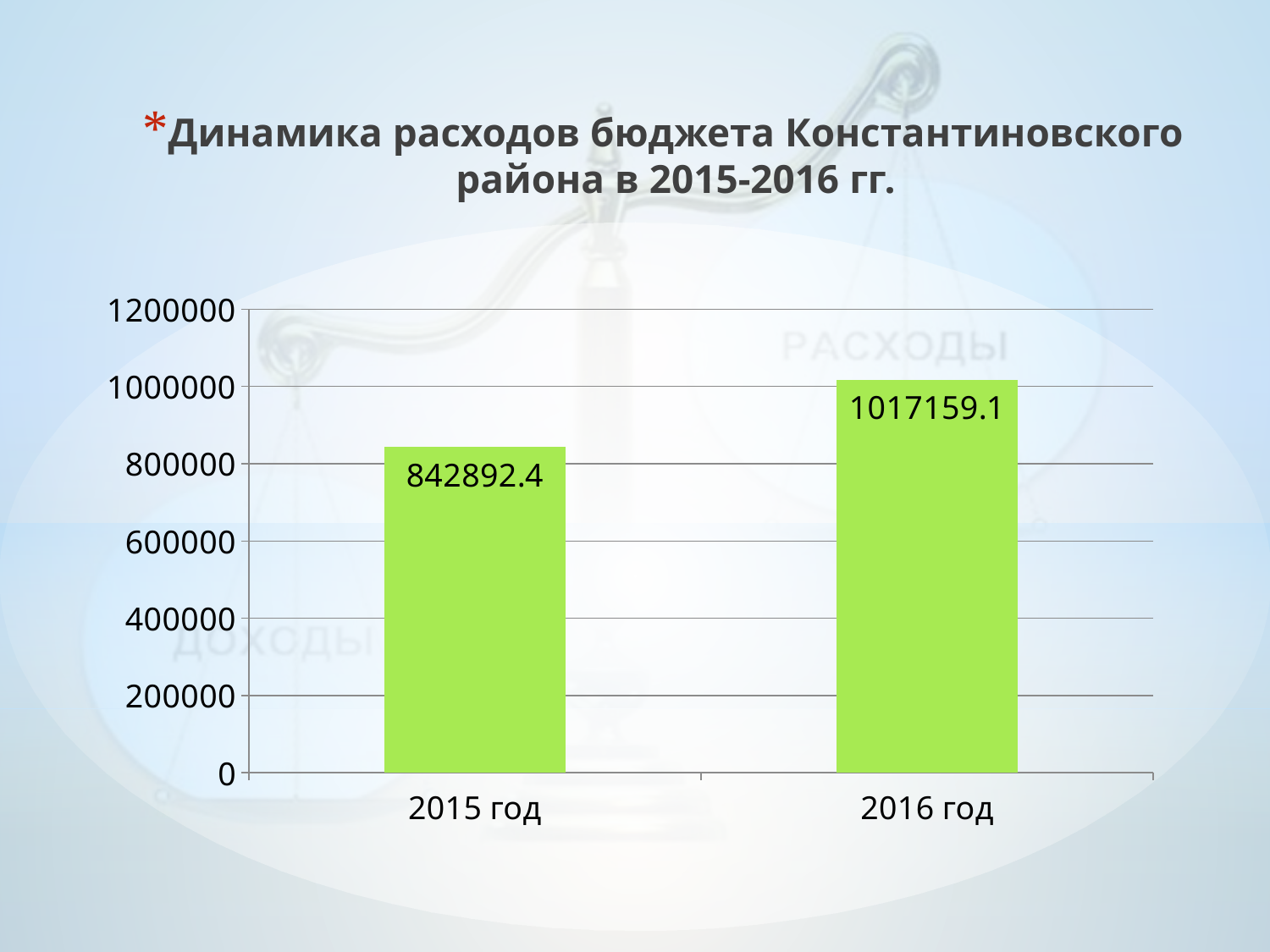
How many categories are shown on the x axis? 2 What kind of chart is shown on the slide? bar chart Which year has the highest value? 2016 год What is the value for 2016 год? 1017159.1 What is the difference between the values for 2016 год and 2015 год? 174266.7 Which year has the lowest value? 2015 год Is the value for 2015 год greater or less than 1000000? less What colour are the bars in the chart? green Do the values rise or fall from 2015 год to 2016 год? rise What is the value for 2015 год? 842892.4 Which is larger, the value for 2015 год or the value for 2016 год? 2016 год Is the value for 2016 год greater or less than 1000000? greater